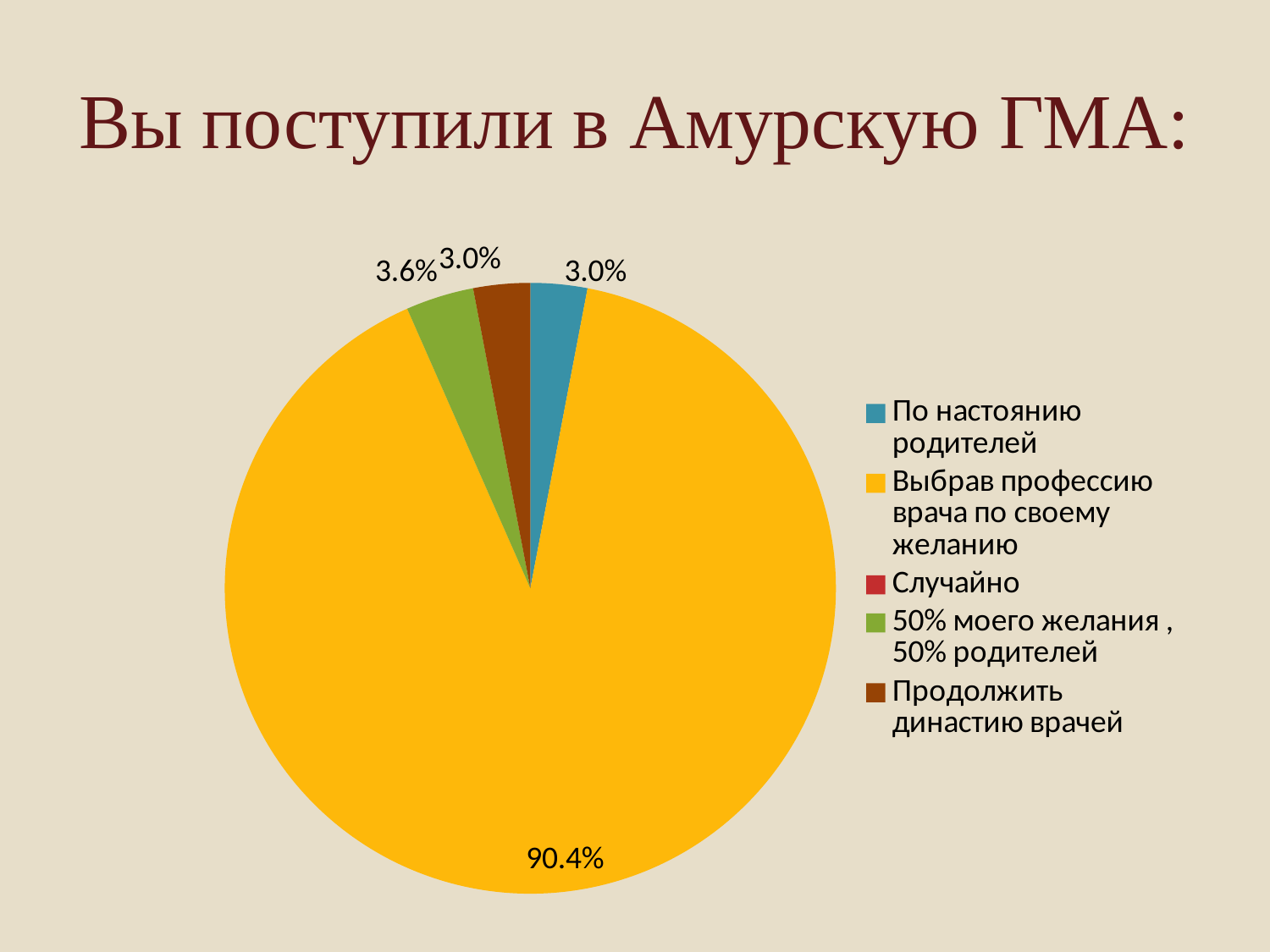
What percentage of the pie corresponds to "Выбрав профессию врача по своему желанию"? 90.4% Which is larger: the share for "50% моего желания , 50% родителей" or the share for "По настоянию родителей"? 50% моего желания , 50% родителей What is the title of the slide with the pie chart? Вы поступили в Амурскую ГМА: What share of the pie does the yellow slice represent? 90.4% Which category has the largest share of the pie? Выбрав профессию врача по своему желанию What colour is the largest slice of the pie? Yellow What percentage is shown for "По настоянию родителей"? 3.0% How many categories does the legend list? 5 What is the difference in percentage points between "Выбрав профессию врача по своему желанию" and "50% моего желания , 50% родителей"? 86.8 What type of chart is shown on the slide? Pie chart What percentage is shown for "50% моего желания , 50% родителей"? 3.6% What percentage is shown for "Продолжить династию врачей"? 3.0%